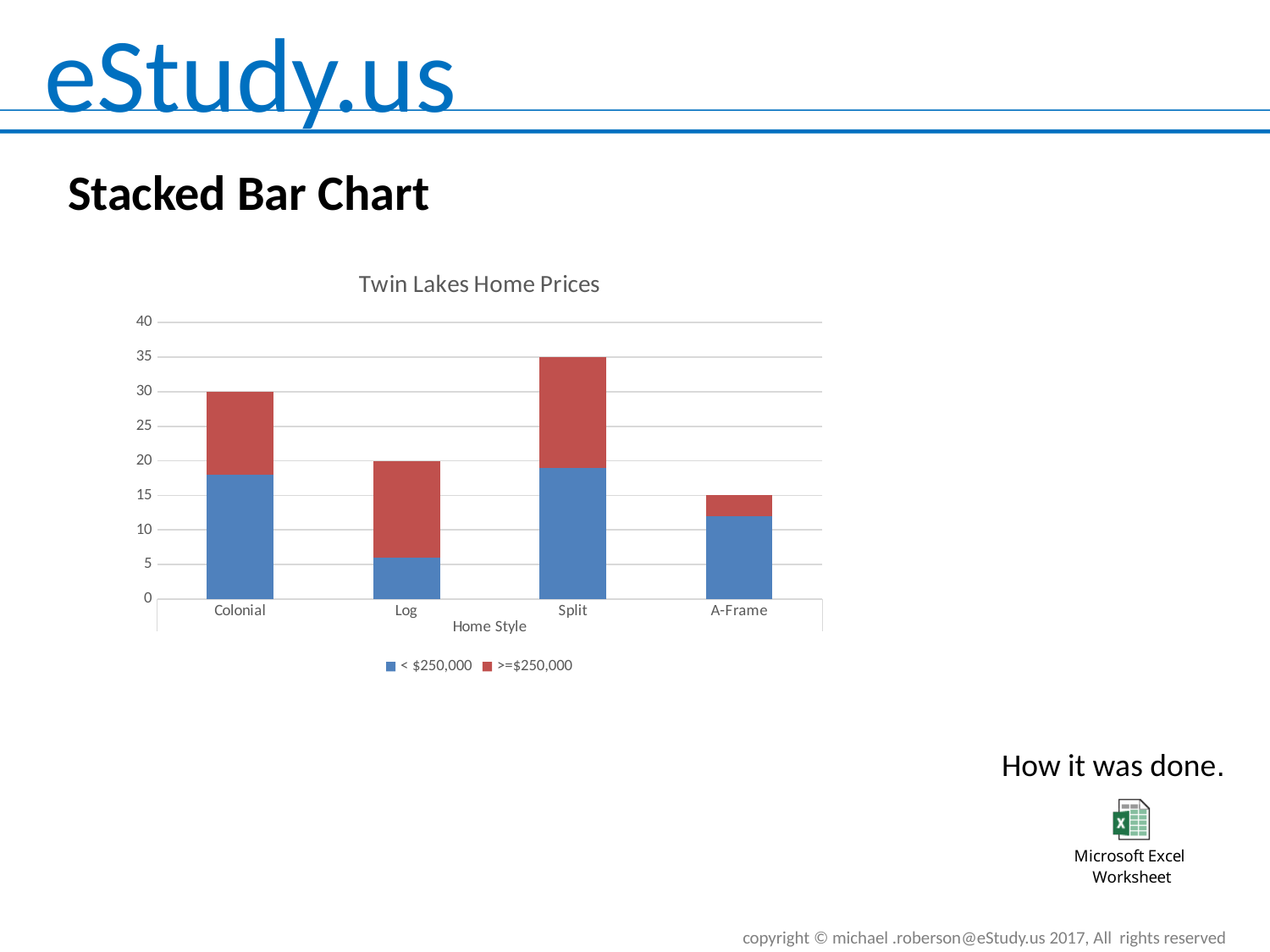
Is the < $250,000 value for Log greater or less than 10? less What is the total height of the stacked bar for Colonial? 30 Which home style has the lowest total stacked bar? A-Frame What is the title of the chart? Twin Lakes Home Prices How many series does the legend list? 2 How many home style categories are shown on the x axis? 4 What kind of chart is shown on the slide? stacked bar chart What is the difference between the total bar heights for Split and Log? 15 What is the total height of the stacked bar for A-Frame? 15 What is the total height of the stacked bar for Split? 35 Which is larger, the total bar for Colonial or the total bar for Log? Colonial Which home style has the highest total stacked bar? Split